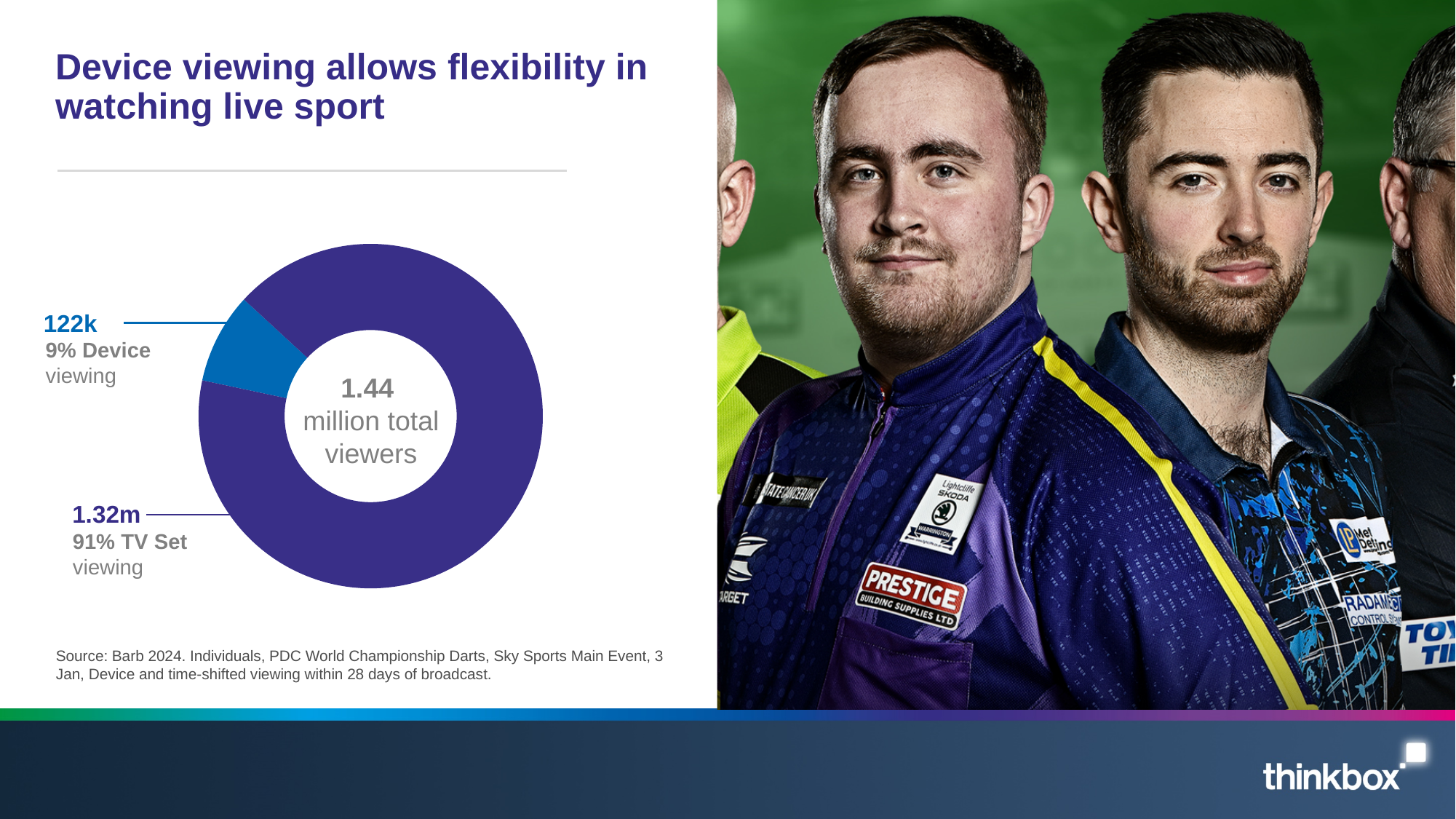
What colour is the Device viewing segment? Blue What share of the chart is Device viewing? 9% What is the difference in percentage share between TV Set viewing and Device viewing? 82 percentage points Which segment is the largest? TV Set viewing How many segments does the chart have? 2 What is the value for TV Set viewing? 1.32m What kind of chart is shown on the slide? Doughnut chart Which is larger, Device viewing or TV Set viewing? TV Set viewing What is the value for Device viewing? 122k What share of the chart is TV Set viewing? 91% Which segment is the smallest? Device viewing What total number of viewers is shown in the centre of the chart? 1.44 million